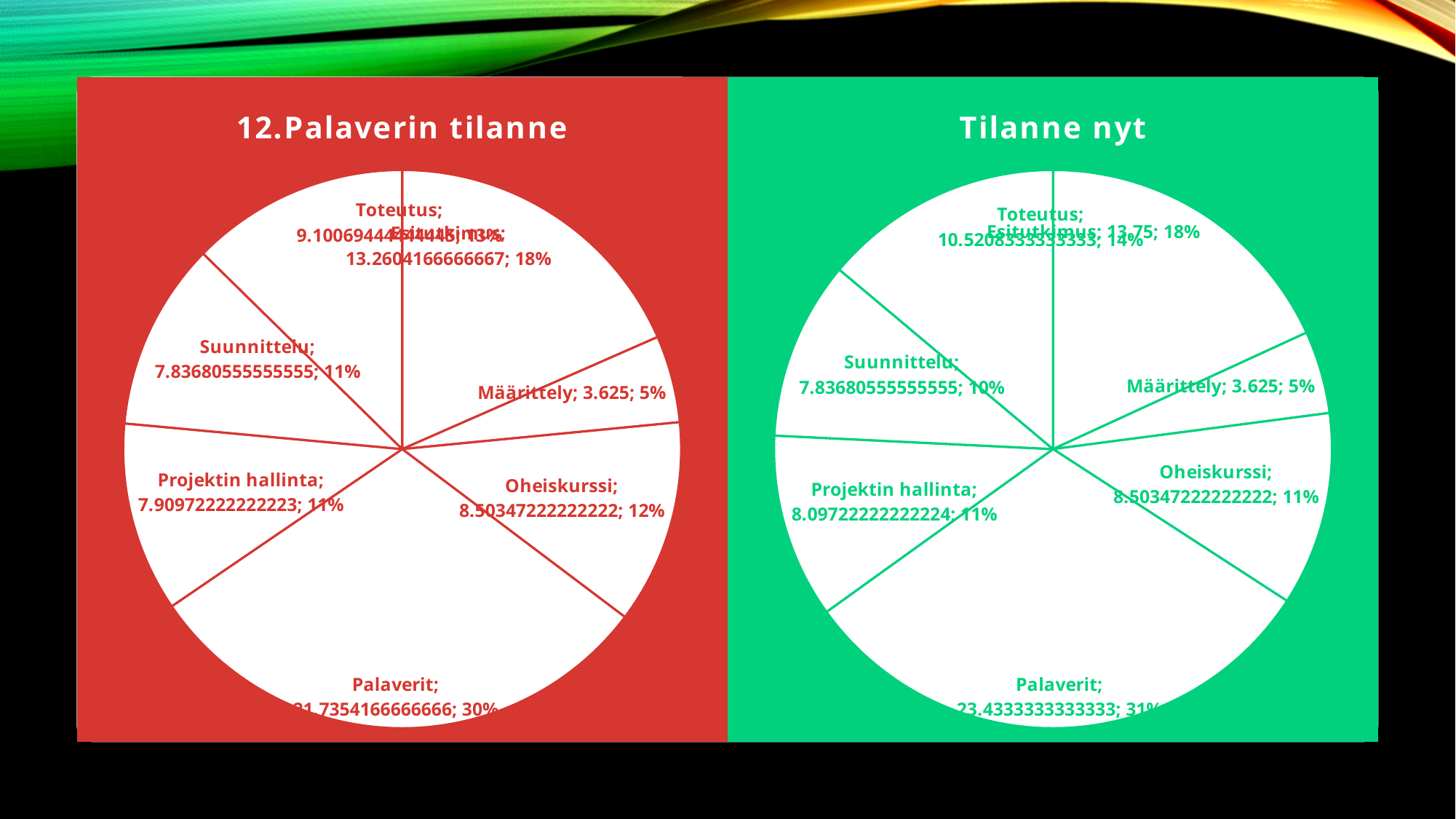
What is the title of the chart on the left side of the slide? 12.Palaverin tilanne How many slices does the "Tilanne nyt" pie chart have? 7 In the "Tilanne nyt" chart, what is the value for Esitutkimus? 13.75 In the "Tilanne nyt" chart, what is the value for Toteutus? 10.5208333333333 In the "12.Palaverin tilanne" chart, which category has the largest slice? Palaverit In the "Tilanne nyt" chart, what percentage share does Palaverit have? 31% In the "Tilanne nyt" chart, which category has the smallest slice? Määrittely In the "12.Palaverin tilanne" chart, what is the value for Määrittely? 3.625 In the "Tilanne nyt" chart, which is larger, the slice for Esitutkimus or the slice for Oheiskurssi? Esitutkimus In the "12.Palaverin tilanne" chart, what percentage share does Palaverit have? 30% What type of chart is shown under the title "Tilanne nyt"? pie chart In the "Tilanne nyt" chart, what percentage share does Suunnittelu have? 10%